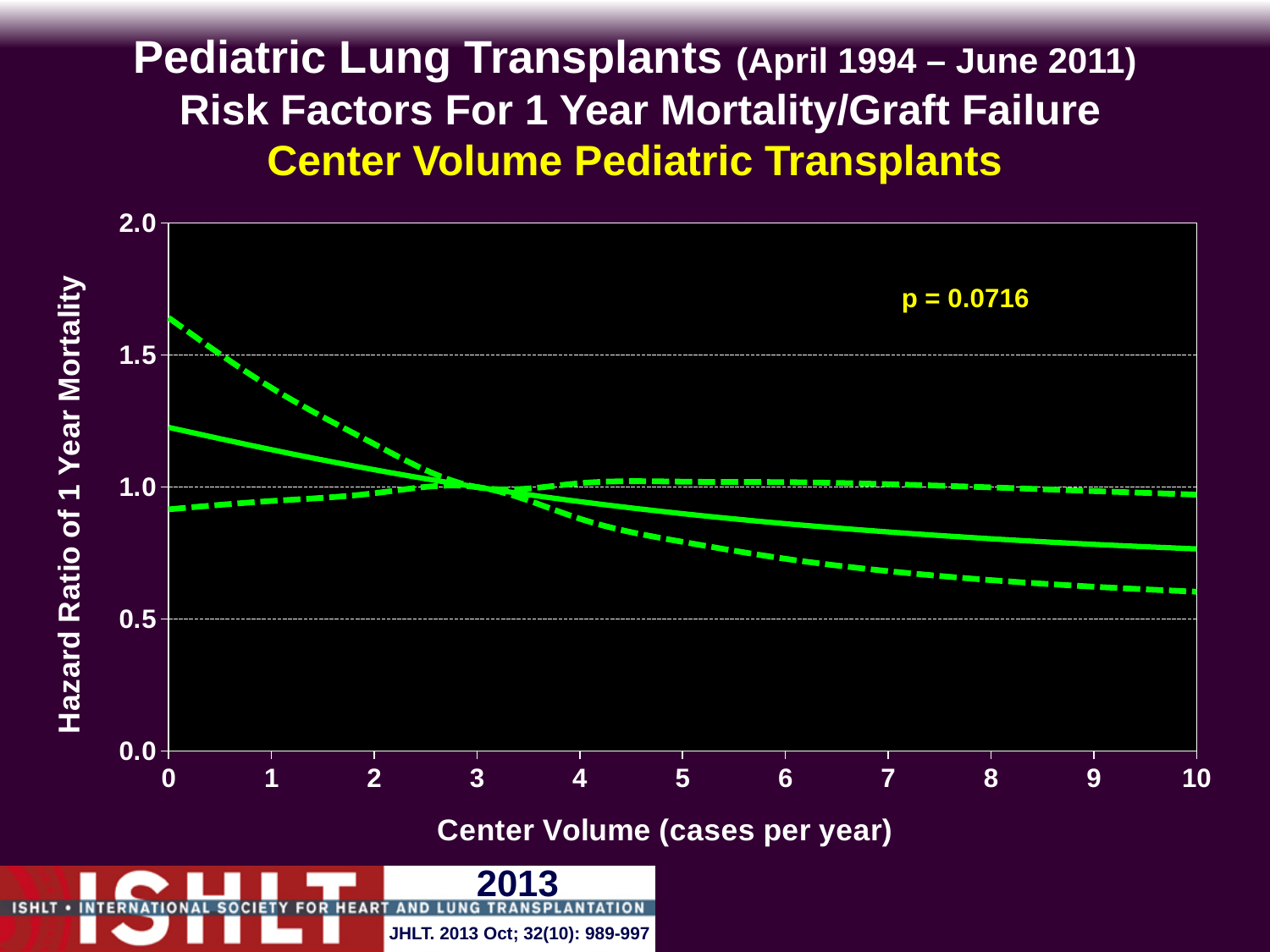
Is the value of the solid line at a center volume of 0 greater or less than 1.0? greater What is the highest tick value shown on the x axis? 10 Is the value of the lower dashed line at a center volume of 10 greater or less than 0.5? greater Is the value of the upper dashed line at a center volume of 0 greater or less than 1.5? greater What kind of chart is shown on the slide? line chart How many lines are plotted on the chart? 3 Does the solid line rise or fall as center volume increases from 0 to 10 cases per year? fall What is the highest tick value shown on the y axis? 2.0 What is the label of the x axis? Center Volume (cases per year) What p-value is printed on the chart? p = 0.0716